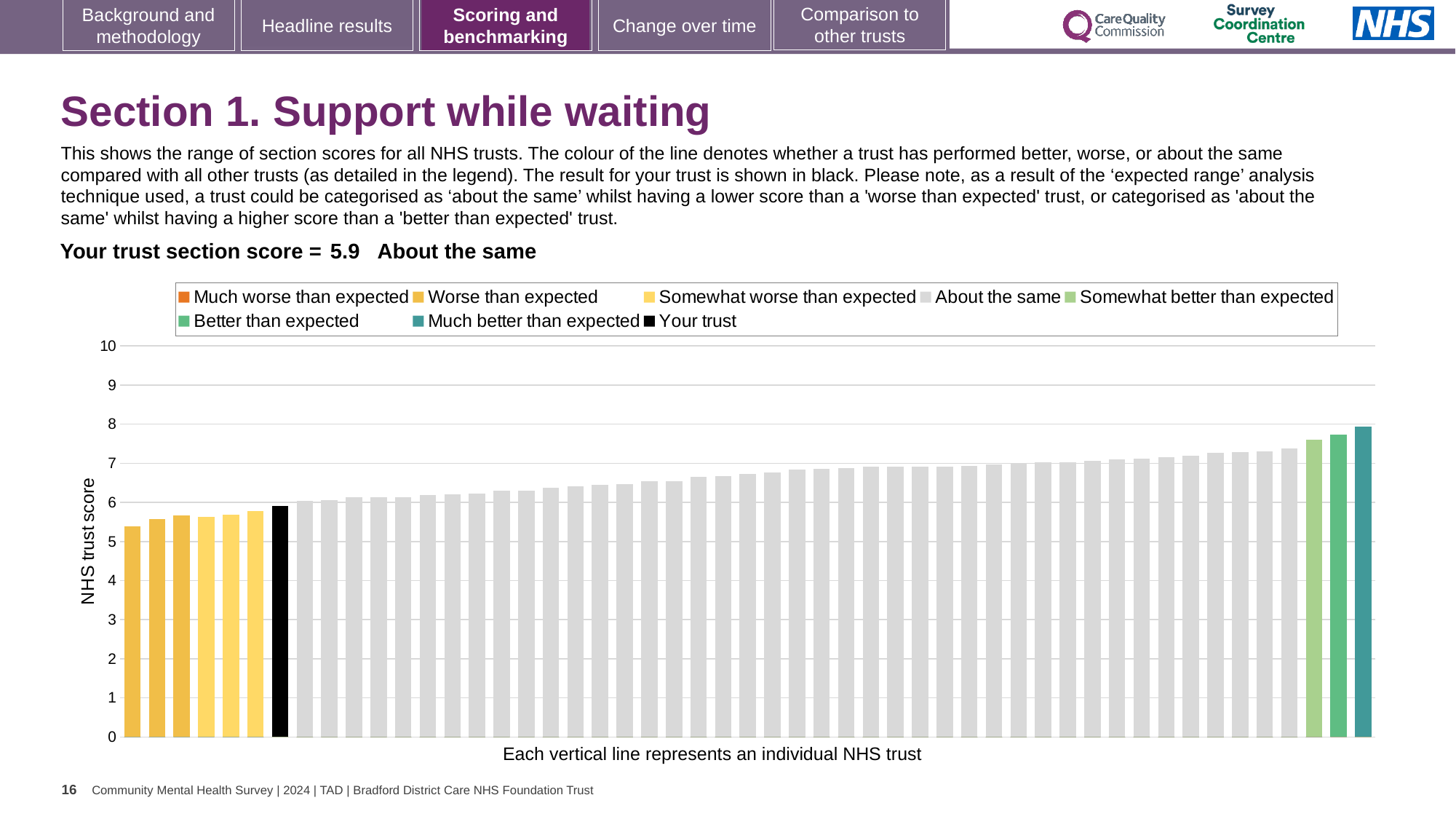
How many entries does the chart legend list? 8 What kind of chart is shown on the slide? bar chart What colour is used for the bar representing your trust? black Which performance category is your trust placed in for this section? About the same Do the bar values rise or fall moving from left to right along the x axis? rise What is the title of the vertical axis? NHS trust score Is the value of the shortest bar in the chart greater or less than 6? less Is the value of the tallest bar in the chart greater or less than 7? greater What is the section score for your trust shown on the slide? 5.9 How many bars are coloured as 'Worse than expected'? 3 Is the value of the shortest bar in the chart greater or less than 5? greater